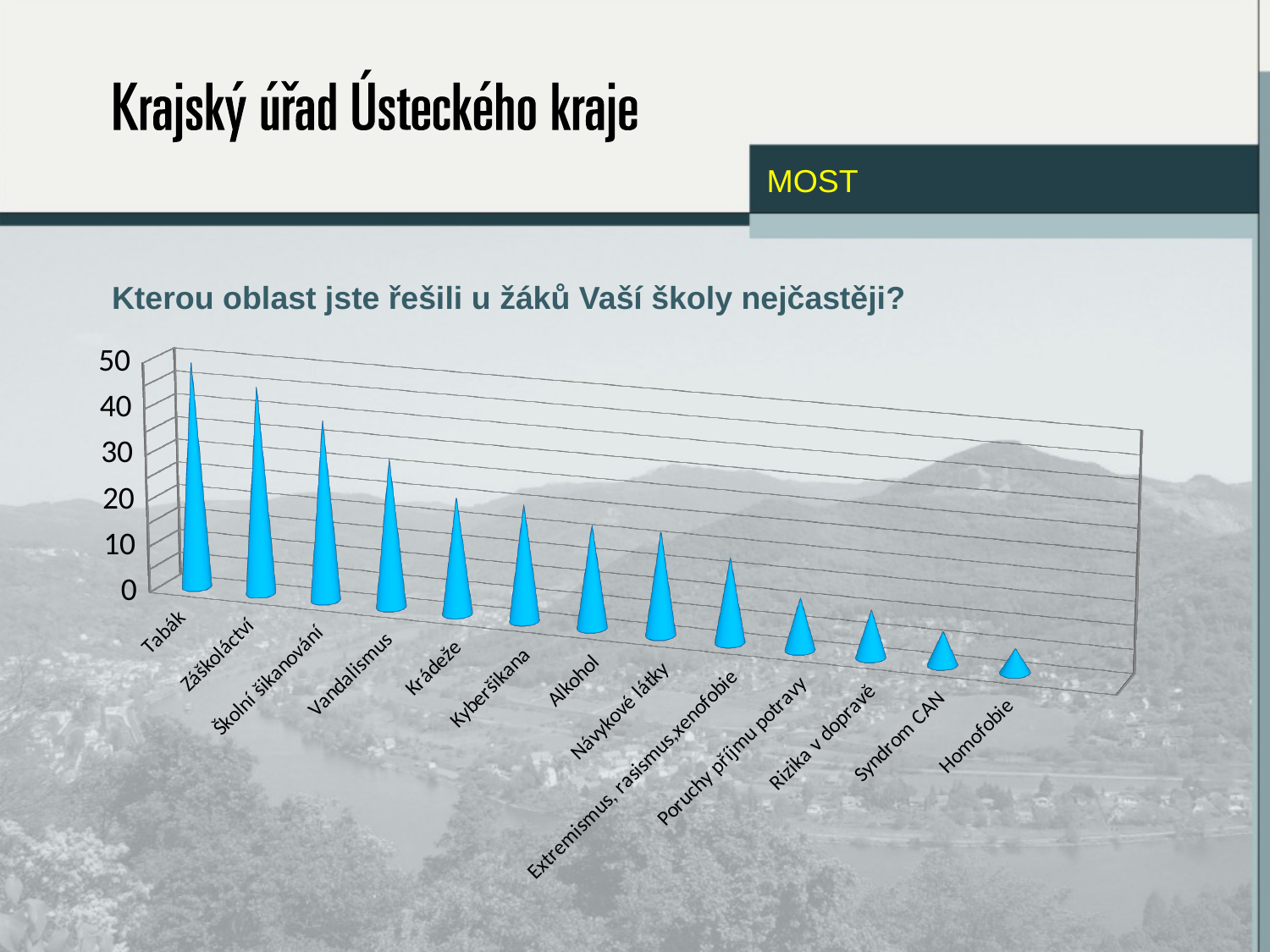
Is the value for Krádeže greater or less than 30? less Do the values rise or fall moving from left to right along the x axis? fall How many categories are plotted on the chart? 13 Which category has the highest value? Tabák What is the title of the chart? Kterou oblast jste řešili u žáků Vaší školy nejčastěji? What colour are the bars on the chart? blue Is the value for Tabák greater or less than 40? greater Which is larger, the value for Záškoláctví or the value for Školní šikanování? Záškoláctví Is the value for Homofobie greater or less than 10? less What kind of chart is shown on the slide? bar chart